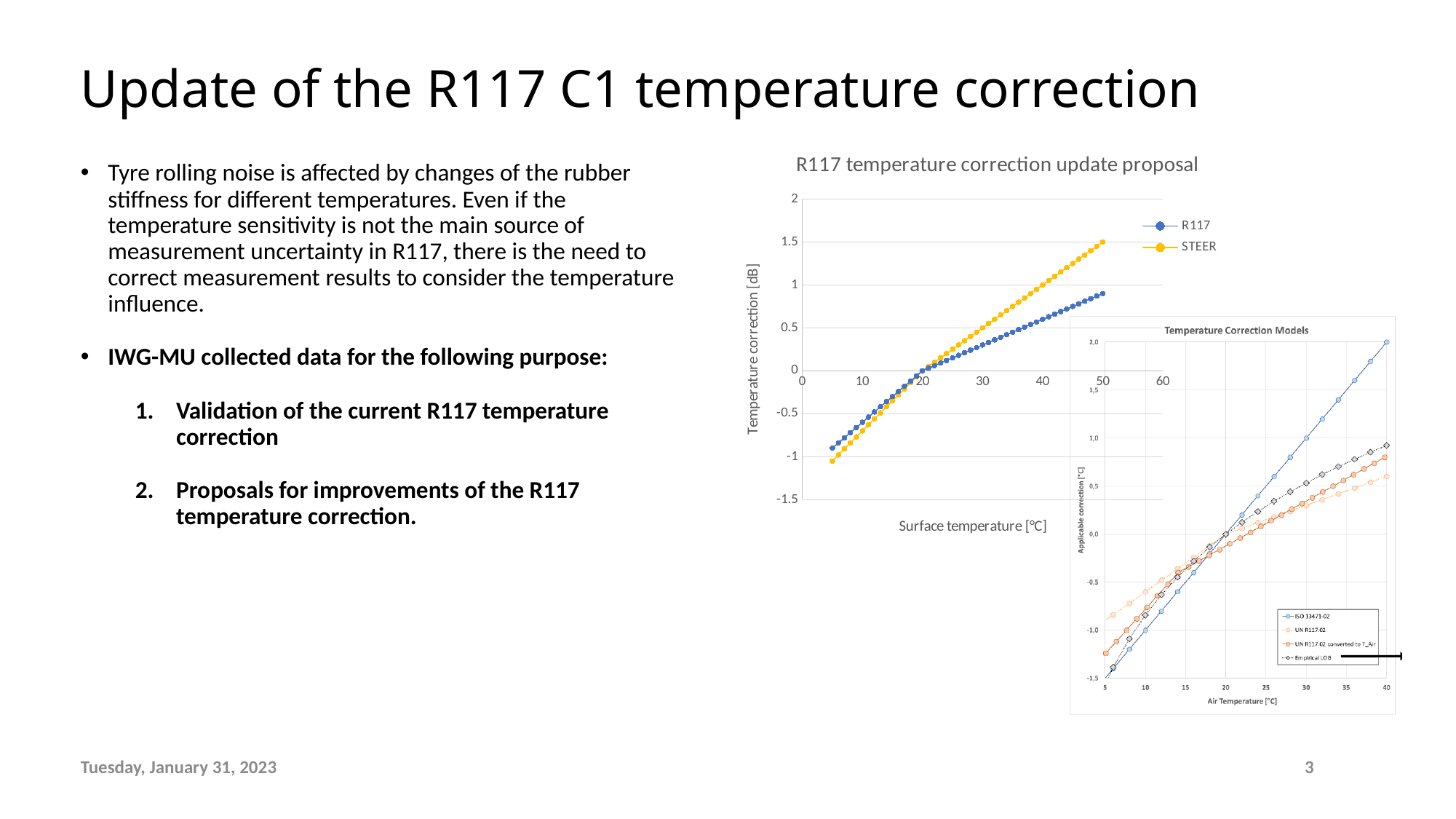
In the chart titled 'R117 temperature correction update proposal', is the STEER value at 50 °C greater or less than 1? greater In the chart titled 'R117 temperature correction update proposal', what kind of chart is it? line chart In the chart titled 'R117 temperature correction update proposal', how many series does the legend list? 2 In the chart titled 'R117 temperature correction update proposal', what is the label of the x axis? Surface temperature [°C] In the chart titled 'R117 temperature correction update proposal', which series are listed in the legend? R117 and STEER In the chart titled 'Temperature Correction Models', is the ISO 13471-02 value at 40 °C greater or less than 1.5? greater In the chart titled 'R117 temperature correction update proposal', is the R117 value at 50 °C greater or less than 1? less In the chart titled 'R117 temperature correction update proposal', which series has the higher value at 40 °C, R117 or STEER? STEER In the chart titled 'R117 temperature correction update proposal', which series has the higher value at 10 °C, R117 or STEER? R117 In the chart titled 'Temperature Correction Models', which series has the highest value at 40 °C air temperature? ISO 13471-02 In the chart titled 'Temperature Correction Models', how many series does the legend list? 4 In the chart titled 'R117 temperature correction update proposal', do the STEER values rise or fall as surface temperature increases? rise